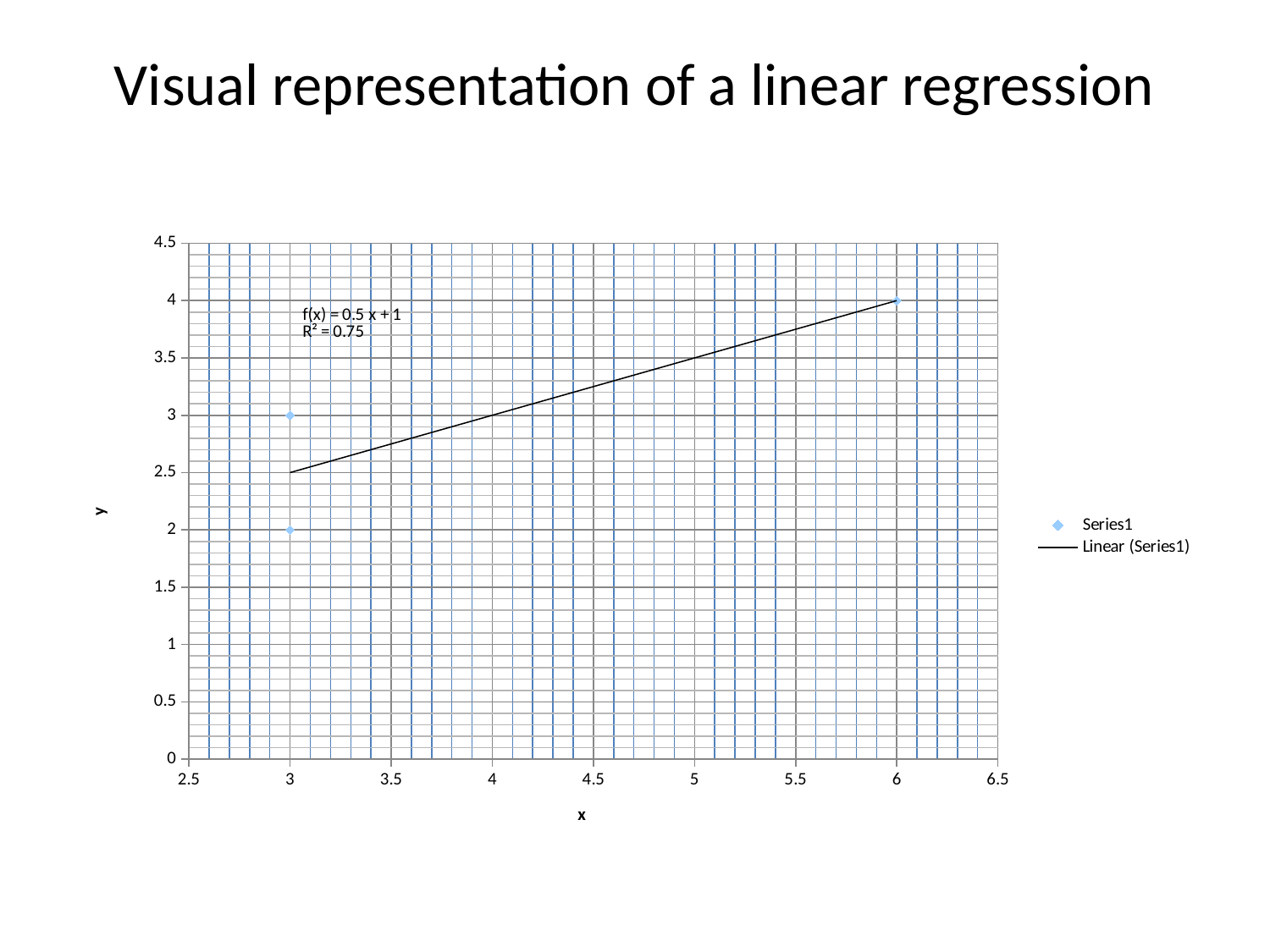
What is the highest y value among the plotted data points? 4 What kind of chart is shown on the slide? scatter chart Does the trendline rise or fall as x increases? rises Which has the larger y value: the point at x = 6 or the lower point at x = 3? the point at x = 6 How many entries does the legend list? 2 What is the lowest y value among the plotted data points? 2 What is the y value of the data point plotted at x = 6? 4 Is the y value of the point at x = 6 greater or less than 3.5? greater How many data points are plotted for Series1? 3 What is the difference between the highest and lowest y values of the plotted points? 2 What is the equation of the trendline shown on the chart? f(x) = 0.5 x + 1 What R² value is shown on the chart? 0.75